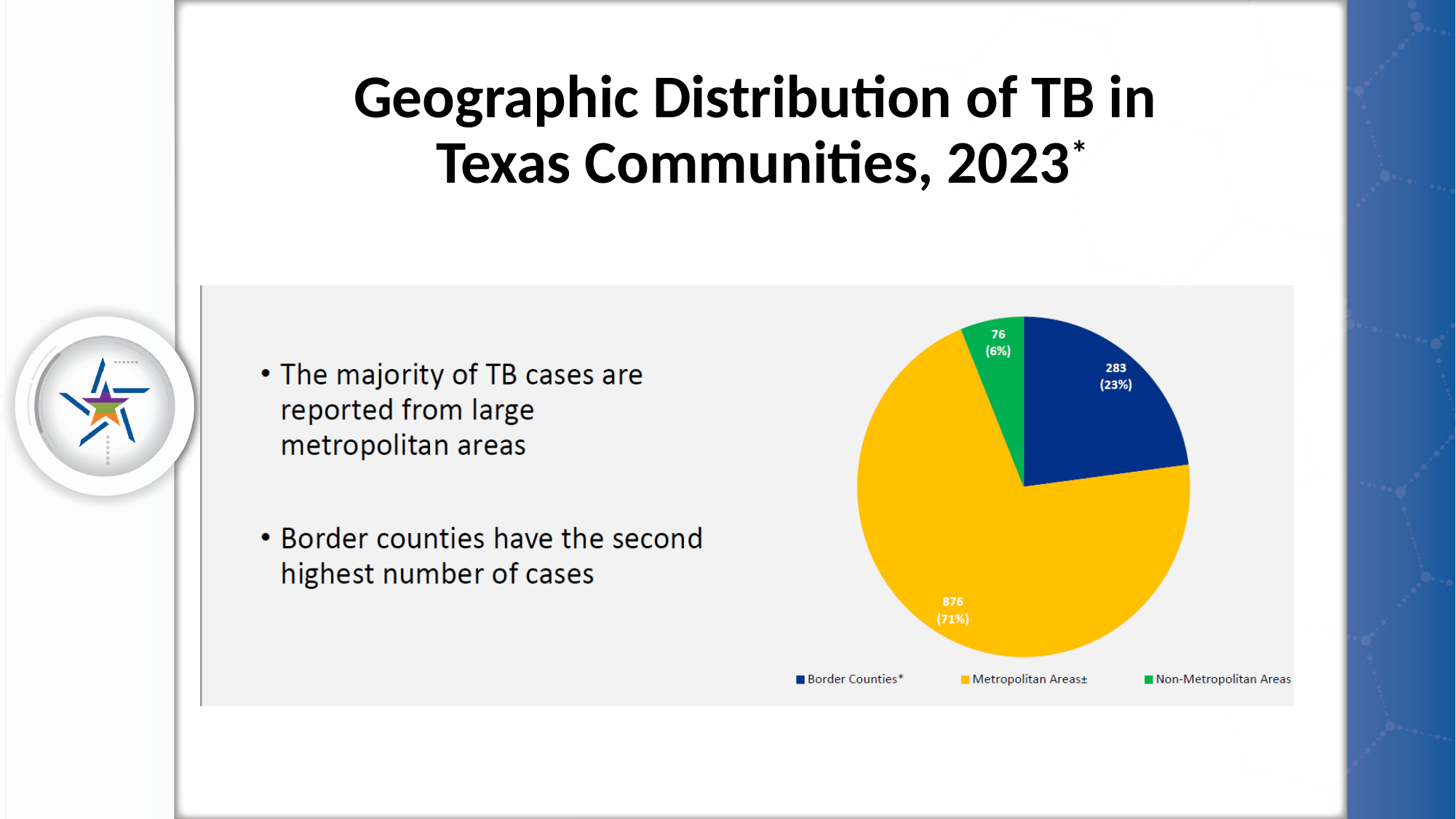
What kind of chart is shown on the slide? pie chart How many categories does the pie chart show? 3 Which has more cases, Border Counties or Non-Metropolitan Areas? Border Counties What share of the pie do Border Counties represent? 23% How many TB cases are shown for Metropolitan Areas? 876 What share of the pie do Non-Metropolitan Areas represent? 6% How many TB cases are shown for Non-Metropolitan Areas? 76 What is the difference in cases between Metropolitan Areas and Border Counties? 593 Which category has the smallest slice of the pie? Non-Metropolitan Areas How many TB cases are shown for Border Counties? 283 What share of the pie do Metropolitan Areas represent? 71% Which category has the largest slice of the pie? Metropolitan Areas